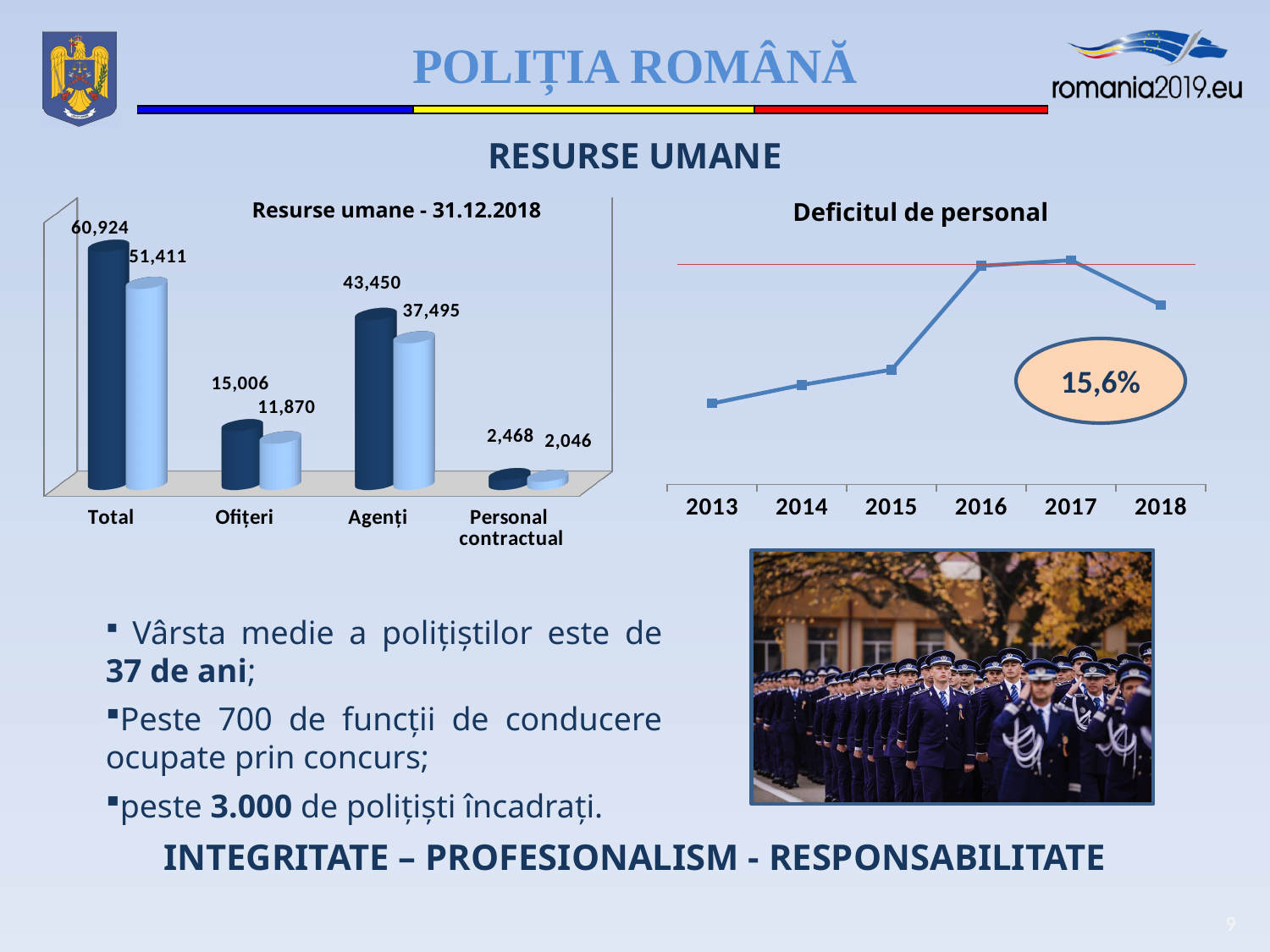
In the chart titled "Resurse umane - 31.12.2018", what value is shown on the dark blue bar for Total? 60,924 In the chart titled "Resurse umane - 31.12.2018", what value is shown on the light blue bar for Agenți? 37,495 In the chart titled "Resurse umane - 31.12.2018", what is the difference between the dark blue and light blue bars for Ofițeri? 3,136 In the chart titled "Resurse umane - 31.12.2018", what value is shown on the dark blue bar for Ofițeri? 15,006 In the chart titled "Resurse umane - 31.12.2018", what value is shown on the light blue bar for Personal contractual? 2,046 In the chart titled "Resurse umane - 31.12.2018", which category has the lowest values? Personal contractual What kind of chart is "Resurse umane - 31.12.2018"? Bar chart In the chart titled "Resurse umane - 31.12.2018", excluding Total, which category has the highest values? Agenți In the chart titled "Deficitul de personal", does the line rise or fall between 2017 and 2018? Fall In the chart titled "Resurse umane - 31.12.2018", how many categories are shown on the x axis? 4 In the chart titled "Resurse umane - 31.12.2018", what is the difference between the dark blue and light blue bars for Total? 9,513 In the chart titled "Deficitul de personal", in which year does the line reach its highest point? 2017